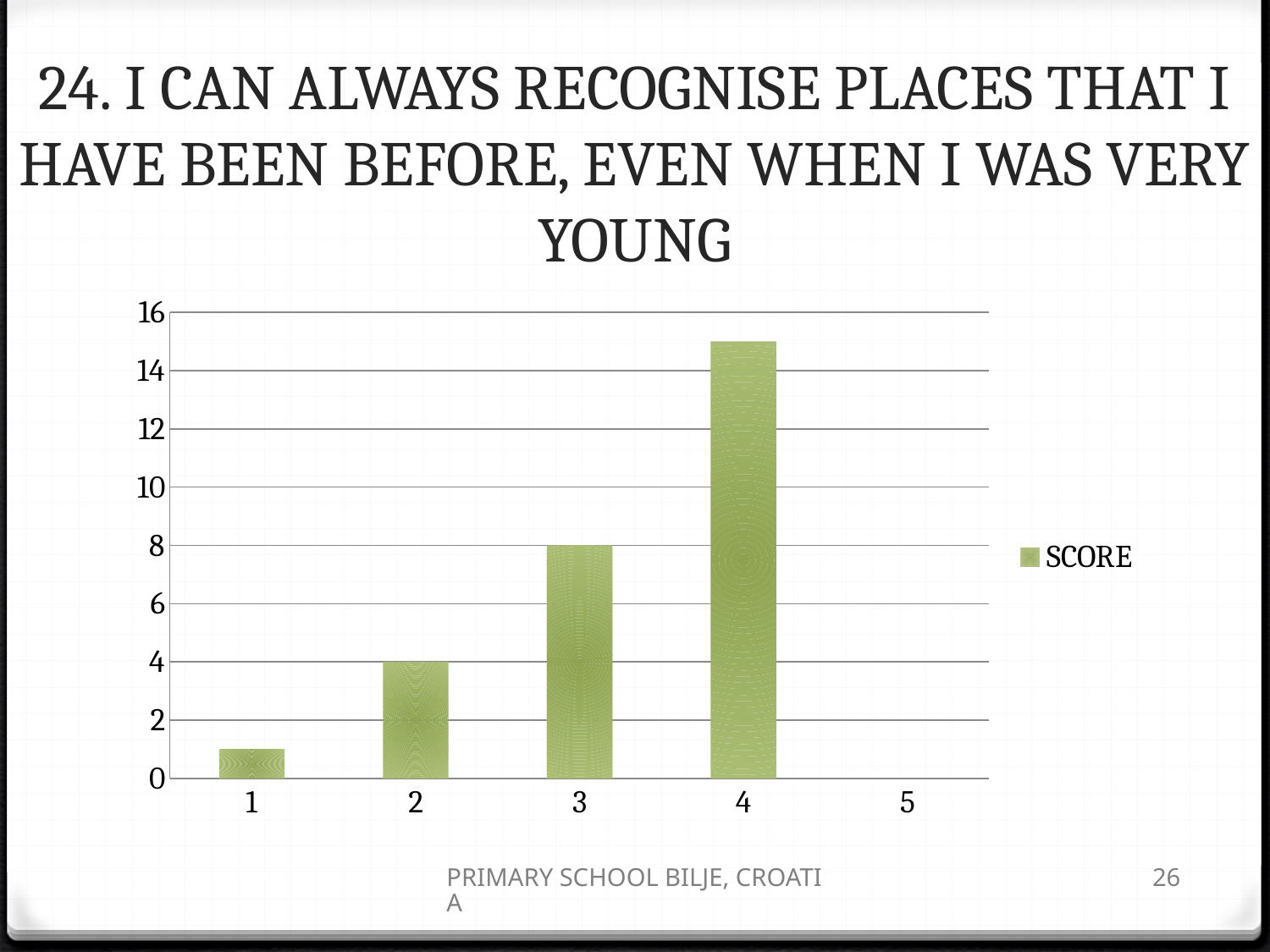
How many categories are shown on the x axis? 5 Is the SCORE value for category 4 greater or less than 14? greater How many series does the legend list? 1 Is the SCORE value for category 1 greater or less than 2? less Which category has the lowest SCORE? 5 What is the name of the series in the legend? SCORE What is the difference between the SCORE values for category 3 and category 2? 4 Which category has the highest SCORE? 4 What kind of chart is shown on the slide? bar chart What is the SCORE value for category 3? 8 What is the SCORE value for category 2? 4 What is the SCORE value for category 5? 0